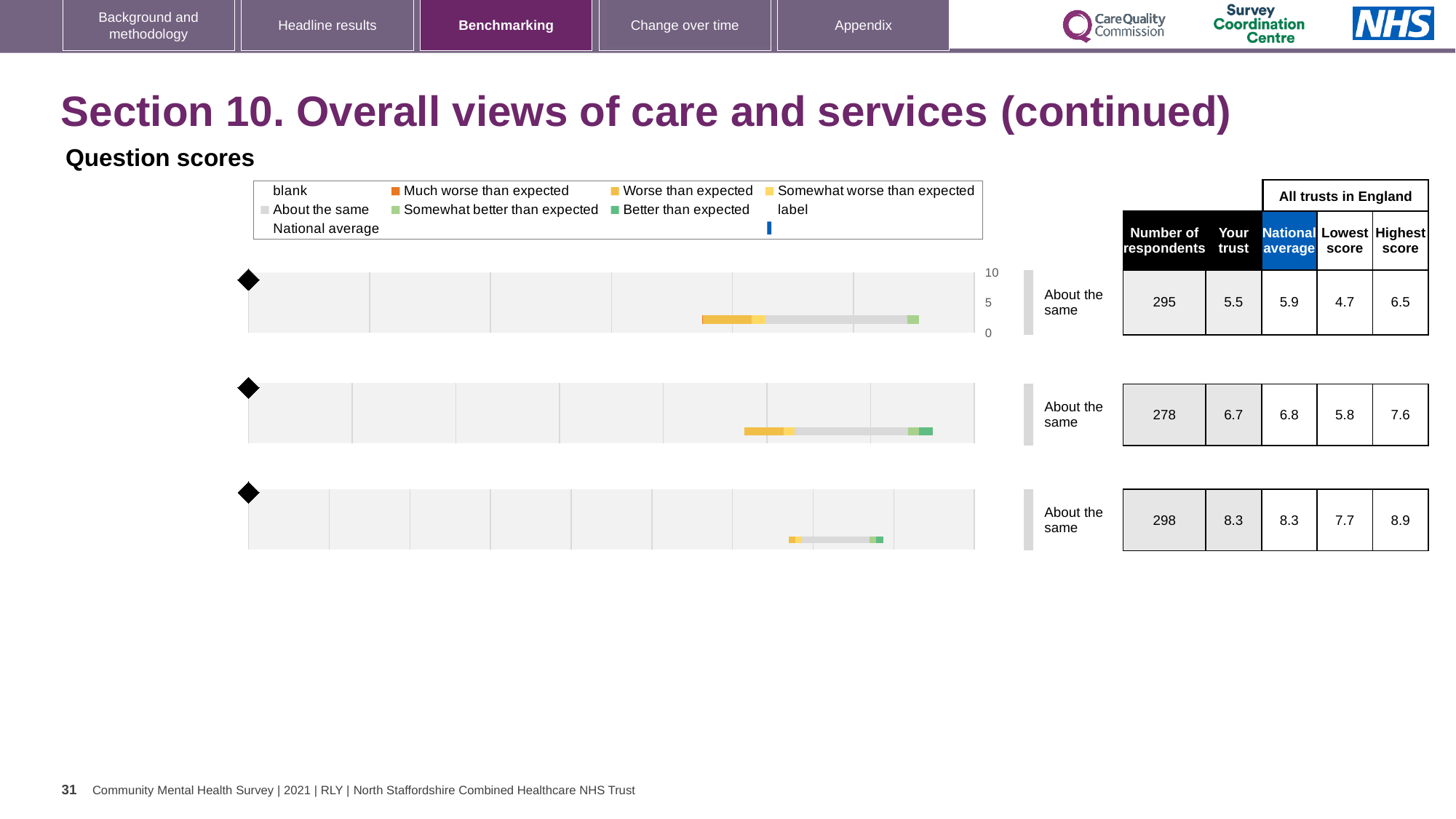
For the top chart, is the 'Your trust' score higher or lower than the national average? lower For the top chart, what is the lowest score among all trusts in England? 4.7 For the bottom chart, how many respondents are there? 298 For the top chart, what is the 'Your trust' score? 5.5 For the middle chart, what is the national average score? 6.8 What kind of chart is used to show the question scores on this slide? bar chart What benchmark category is shown next to the middle chart? About the same For the top chart, what is the difference between the national average and the 'Your trust' score? 0.4 For the bottom chart, what is the difference between the highest score and the lowest score? 1.2 How many question score charts are shown on the slide? 3 Which chart has the highest 'Your trust' score? the bottom chart Which chart has the fewest respondents? the middle chart